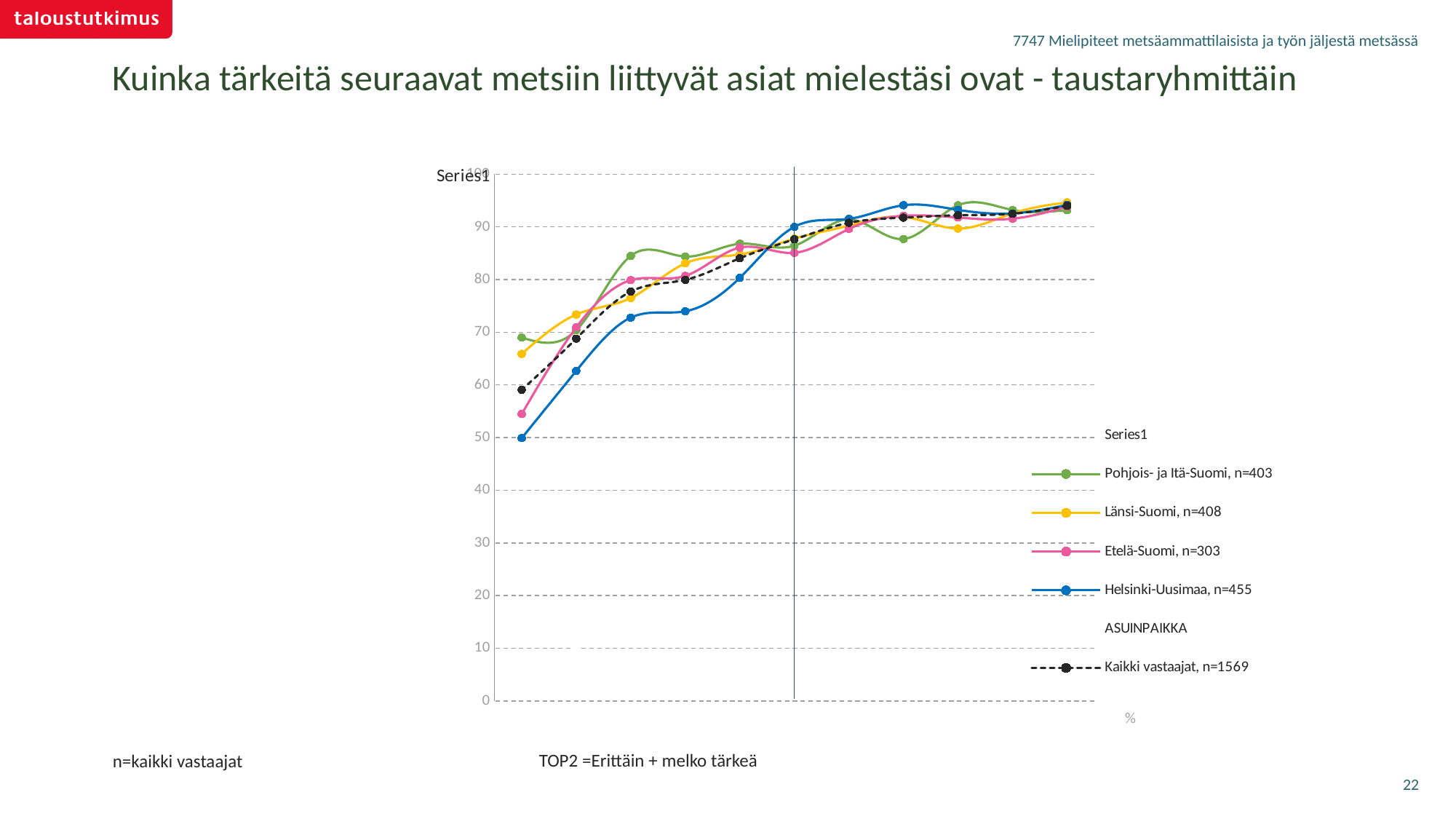
Which series has the highest value at the first (leftmost) point? Pohjois- ja Itä-Suomi Is the fourth point from the left for Helsinki-Uusimaa greater or less than 80? less At the first (leftmost) point, which is larger: Etelä-Suomi or Kaikki vastaajat? Kaikki vastaajat Is the last (rightmost) value for Länsi-Suomi greater or less than 90? greater Is the first (leftmost) value for Helsinki-Uusimaa greater or less than 60? less What kind of chart is shown on the slide? line chart Which series is drawn with a dashed line? Kaikki vastaajat, n=1569 How many lines (data series) are plotted on the chart? 5 Do the values generally rise or fall from left to right along the x axis? rise Which series has the lowest value at the first (leftmost) point? Helsinki-Uusimaa How many data points does each line on the chart have? 11